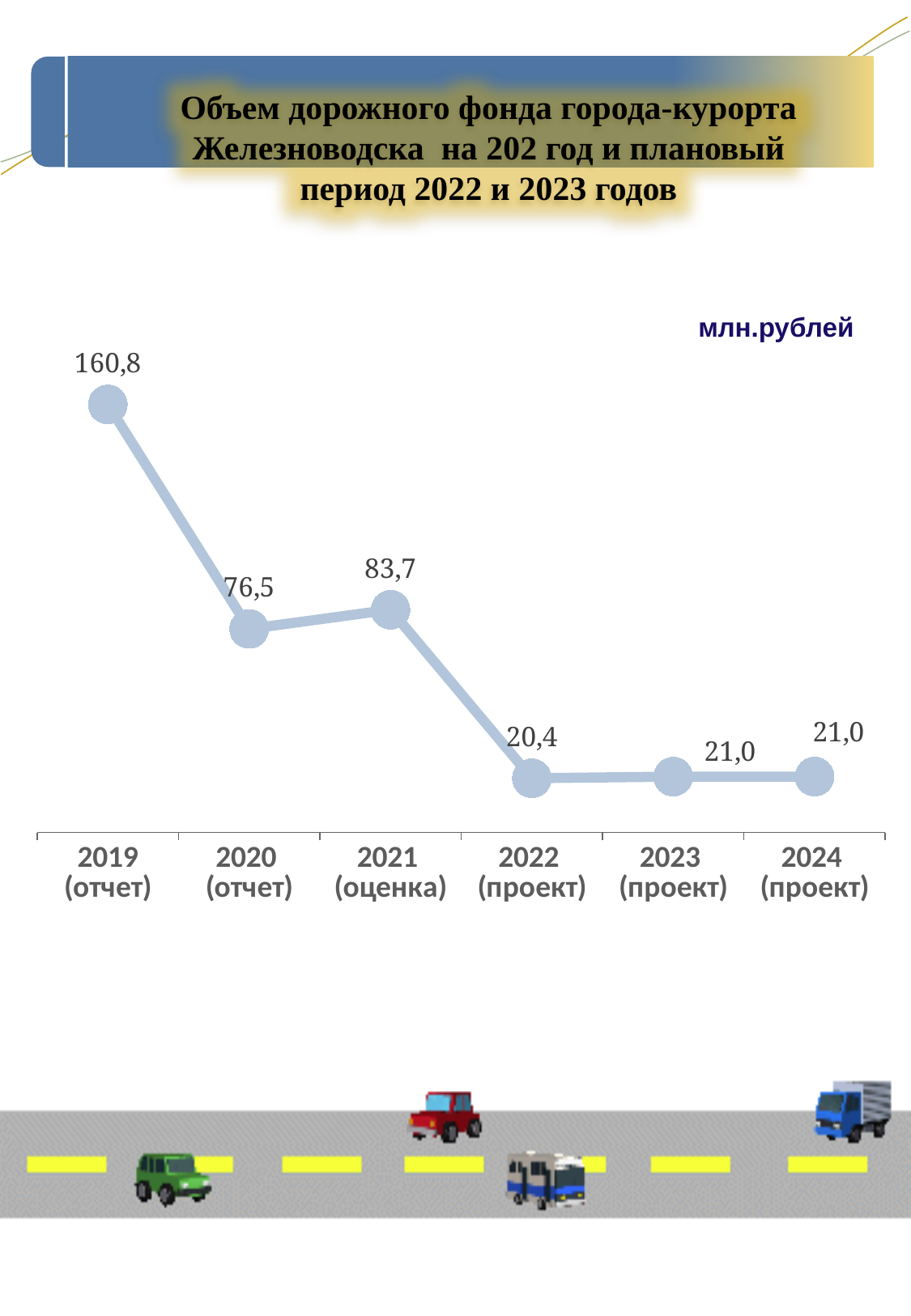
What is the value for 2019 (отчет)? 160,8 What unit is indicated for the values on the chart? млн.рублей Which year has the highest value? 2019 (отчет) What kind of chart is shown on the slide? line chart Which is larger, the value for 2020 (отчет) or 2021 (оценка)? 2021 (оценка) What is the value for 2021 (оценка)? 83,7 What is the value for 2022 (проект)? 20,4 Which year has the lowest value? 2022 (проект) What is the difference between the values for 2021 (оценка) and 2022 (проект)? 63,3 How many data points are plotted on the chart? 6 Do the values generally rise or fall from 2019 to 2024? fall What is the difference between the values for 2019 (отчет) and 2020 (отчет)? 84,3